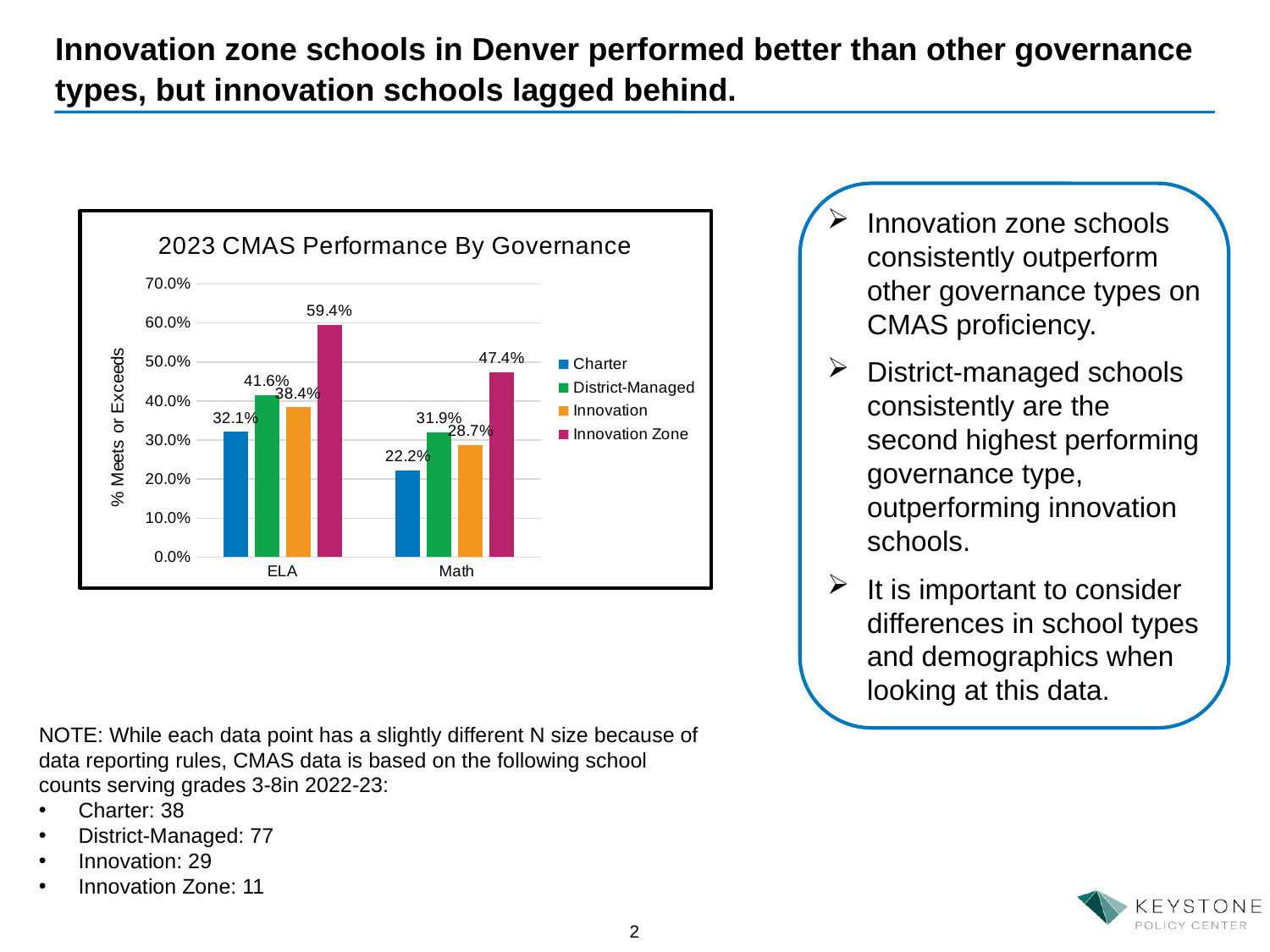
What is the title of the chart? 2023 CMAS Performance By Governance Which governance type has the highest value in Math? Innovation Zone What kind of chart is shown? Bar chart What is the value for Innovation Zone in ELA? 59.4% How many series does the legend list? 4 What is the value for District-Managed in Math? 31.9% Is the value for Innovation Zone in Math greater or less than 40.0%? greater What is the value for Innovation in ELA? 38.4% What is the value for Charter in Math? 22.2% What is the difference between the Innovation Zone and Charter values in ELA? 27.3% Which governance type has the lowest value in ELA? Charter Which is larger in Math: District-Managed or Innovation? District-Managed